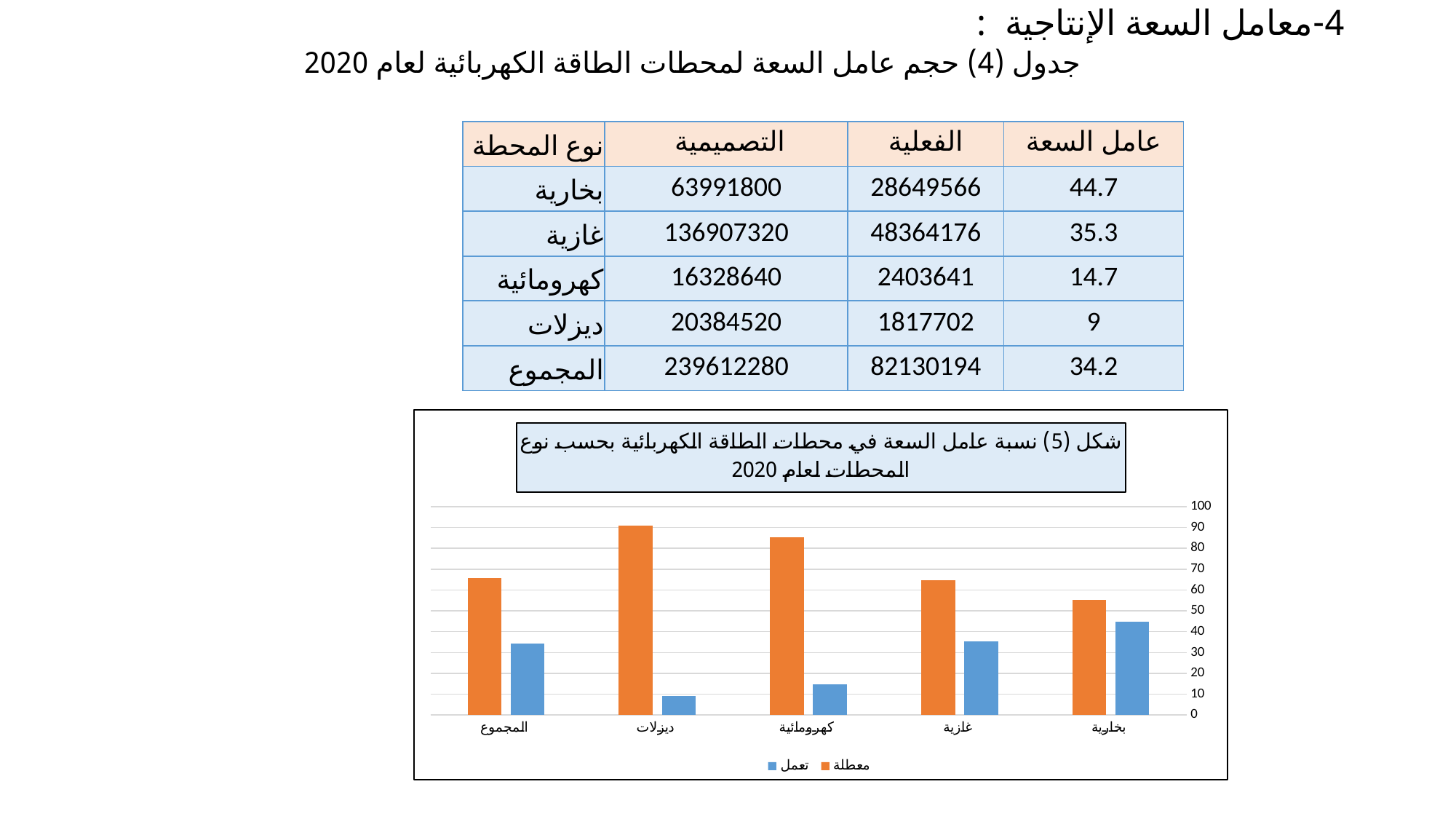
For ديزلات, which bar is taller, the orange (معطلة) or the blue (تعمل)? orange (معطلة) Is the orange (معطلة) value for ديزلات greater or less than 80? greater Which category has the tallest orange (معطلة) bar? ديزلات What kind of chart is shown on the slide? bar chart Which colour represents the تعمل series in the chart legend? blue Which category has the shortest orange (معطلة) bar? بخارية How many series does the chart legend list? 2 Which category has the tallest blue (تعمل) bar? بخارية Which category has the shortest blue (تعمل) bar? ديزلات Is the blue (تعمل) value for بخارية greater or less than 40? greater How many station-type categories are shown on the x axis of the chart? 5 Is the blue (تعمل) value for كهرومائية greater or less than 20? less